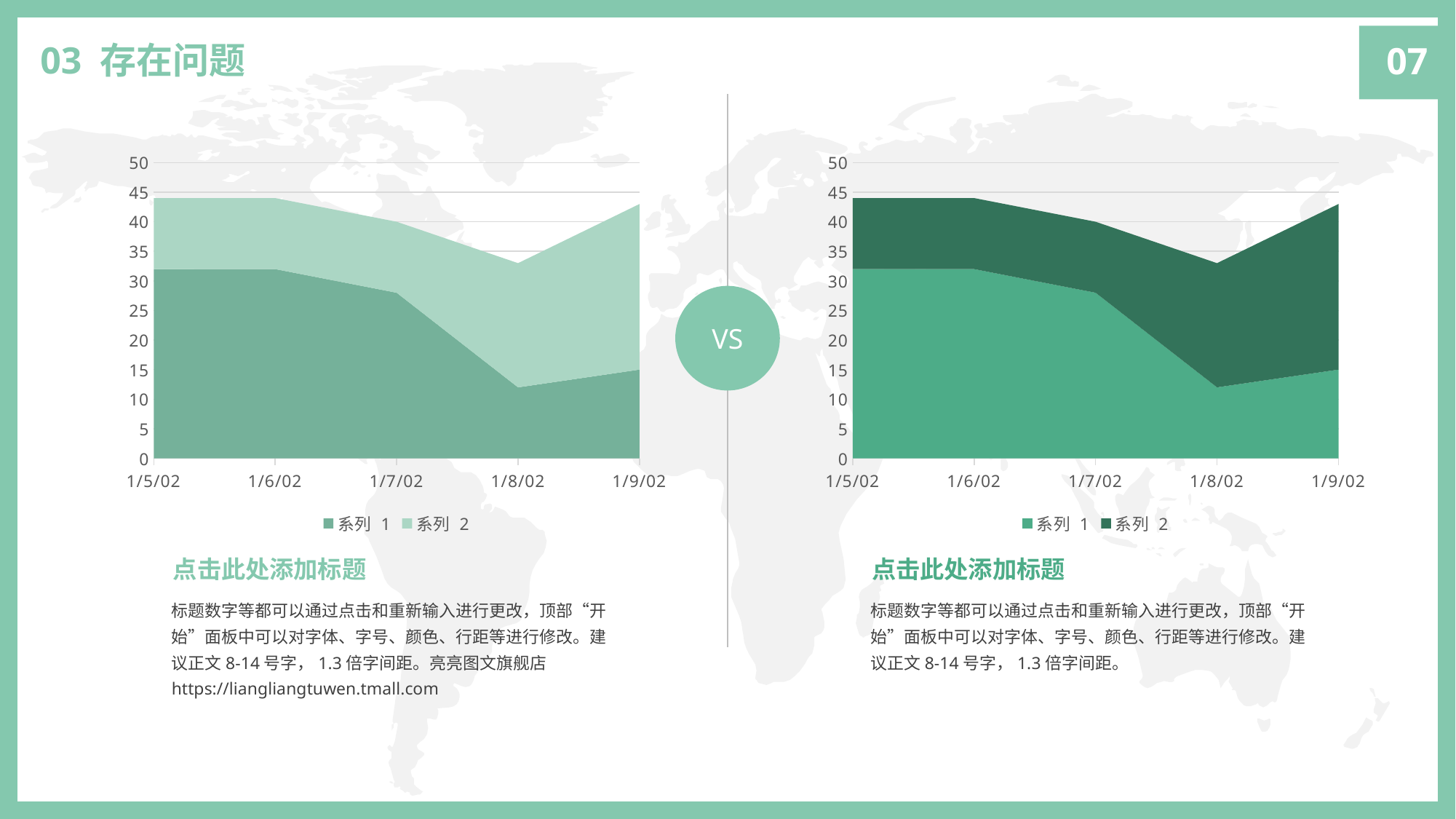
In the left chart, is 系列 1 larger at 1/5/02 or at 1/8/02? 1/5/02 In the left chart, is the stacked total at 1/5/02 greater or less than 40? greater In the right chart, at which date is 系列 1 lowest? 1/8/02 How many series does the legend of the right chart list? 2 What kind of chart is the left chart? stacked area chart In the right chart, is the value for 系列 1 at 1/8/02 greater or less than 15? less In the left chart, is the value for 系列 1 at 1/7/02 greater or less than 30? less How many dates are shown on the x axis of the left chart? 5 What are the names of the two series in the left chart's legend? 系列 1 and 系列 2 In the right chart, does 系列 1 rise or fall from 1/6/02 to 1/8/02? fall